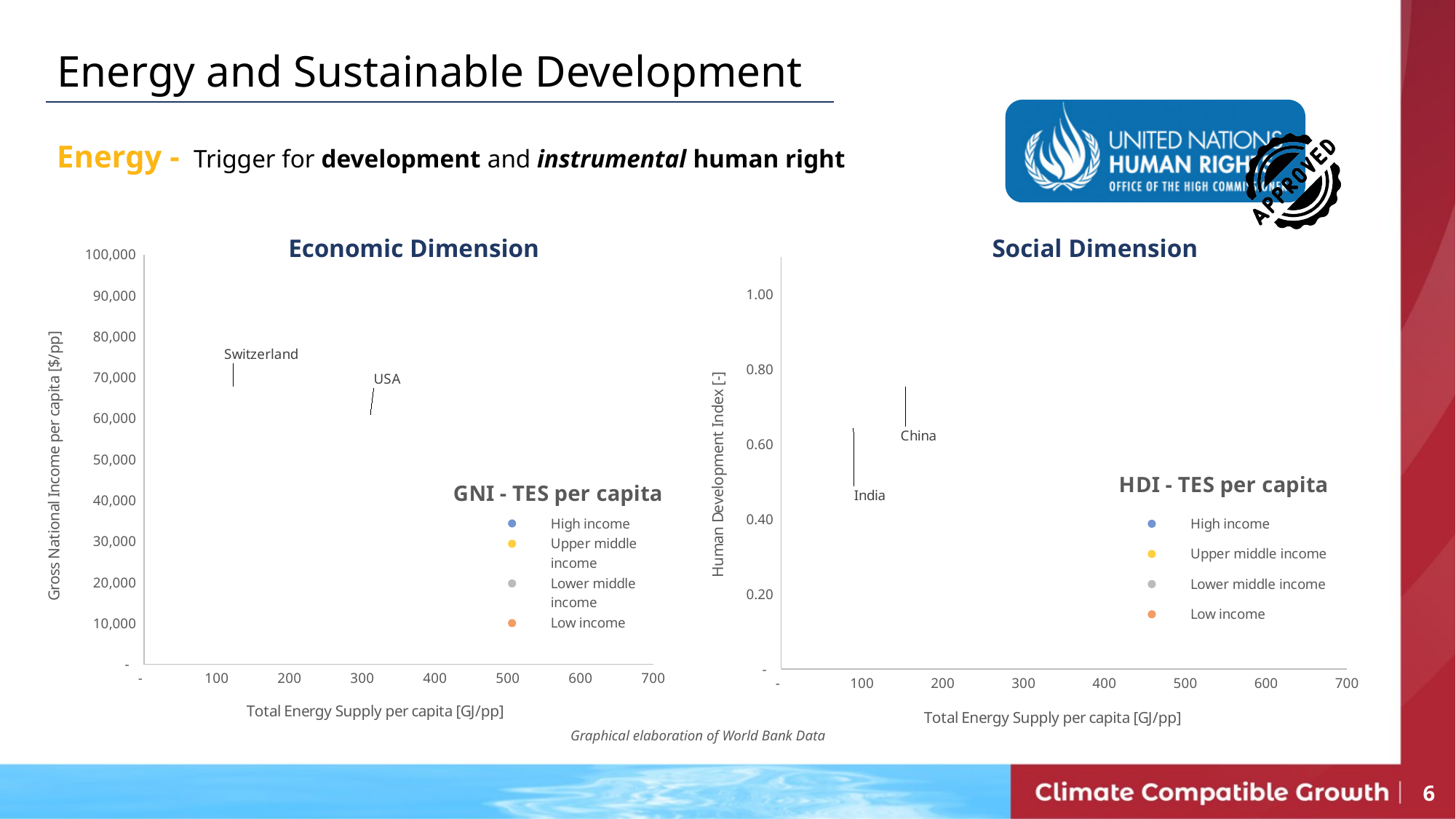
In the Economic Dimension chart, is the Total Energy Supply per capita for USA greater or less than 200? greater In the Social Dimension chart, which labelled country has the higher Human Development Index, India or China? China In the Social Dimension chart, is the Human Development Index for China greater or less than 0.60? greater How many series does the legend of the Social Dimension chart list? 4 In the Economic Dimension chart, is the Gross National Income per capita for USA greater or less than 50,000? greater What is the y-axis title of the Social Dimension chart? Human Development Index [-] What kind of chart is the Economic Dimension chart? bubble chart What is the legend title of the Economic Dimension chart? GNI - TES per capita